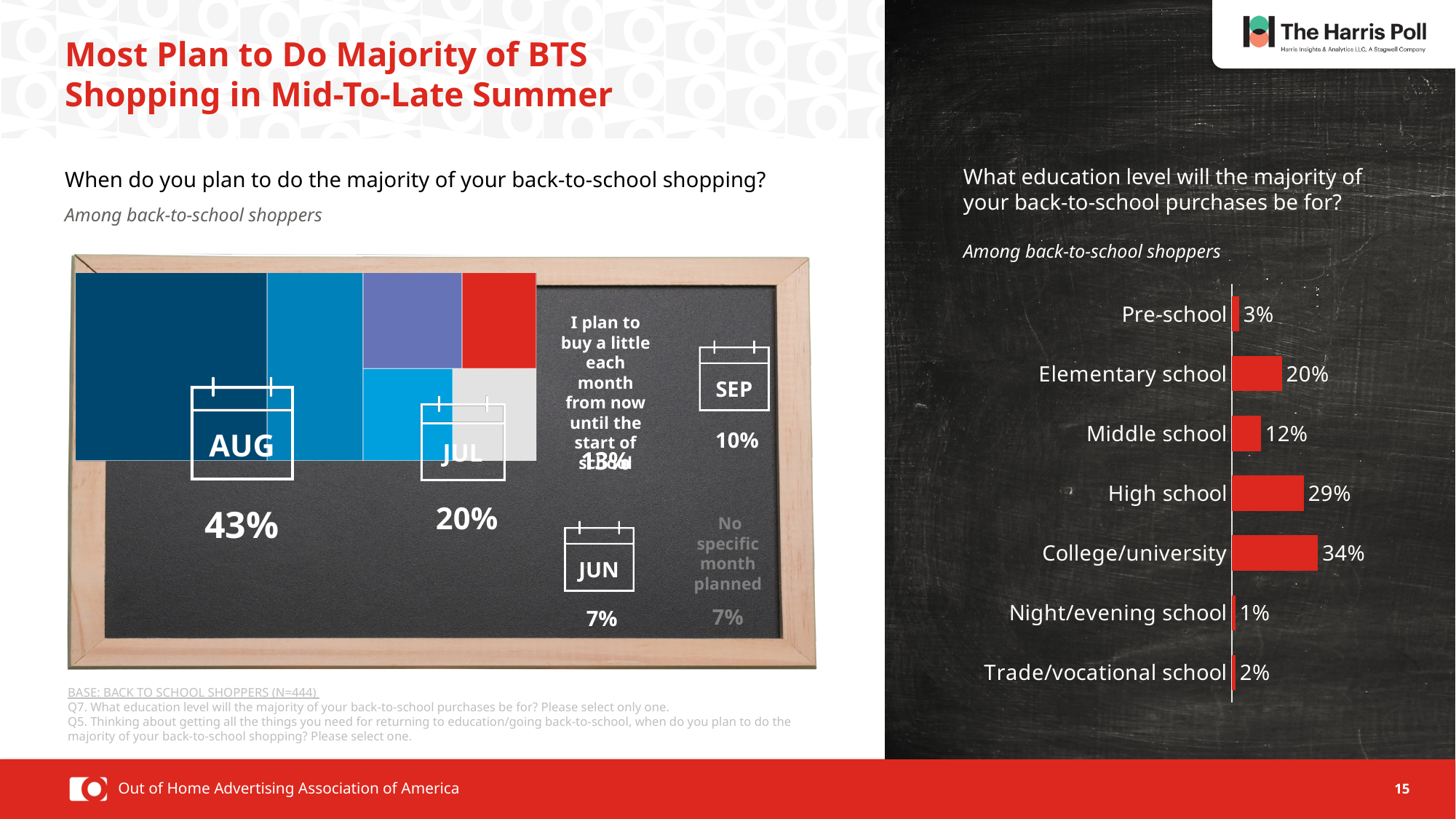
In the chart on the left about when shoppers plan to do their back-to-school shopping, which month has the highest percentage? AUG In the chart on the left about when shoppers plan to do their back-to-school shopping, what percentage plan to shop in July? 20% In the chart on the left about when shoppers plan to do their back-to-school shopping, what percentage plan to shop in August? 43% In the chart on the right about education level, which is larger: elementary school or middle school? Elementary school In the chart on the right about education level, what percentage of back-to-school purchases will be for college/university? 34% In the chart on the right about education level, which education level has the lowest value? Night/evening school In the chart on the right about education level, which education level has the highest value? College/university In the chart on the left about when shoppers plan to do their back-to-school shopping, what is the difference between the August and September percentages? 33% In the chart on the right about education level, what is the value for high school? 29% In the chart on the right about education level, what is the difference between the values for college/university and high school? 5% What kind of chart is the chart on the right about education level? Bar chart In the chart on the right about education level, how many education levels are shown? 7